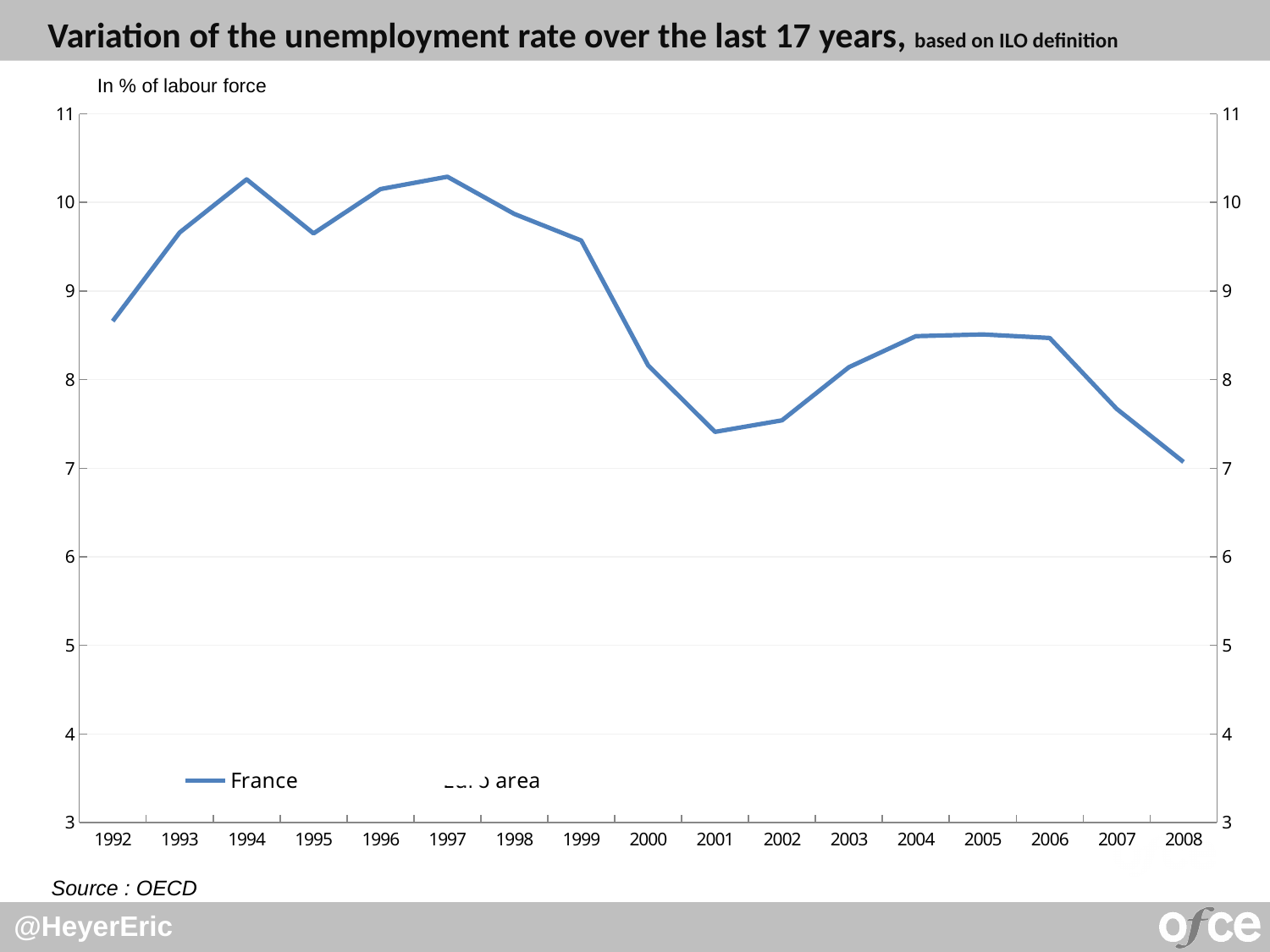
Is the value for France in 2001 greater or less than 8? less Which year has the lowest unemployment rate for France? 2008 Is the value for France in 1994 greater or less than 10? greater What unit is given for the y axis? In % of labour force Is the value for France in 1992 greater or less than 8? greater Does the France unemployment rate rise or fall between 1997 and 2001? fall Does the France unemployment rate rise or fall between 2001 and 2005? rise Which is larger, the France unemployment rate in 1993 or in 2003? 1993 What kind of chart is shown on the slide? line chart How many years are plotted along the x axis? 17